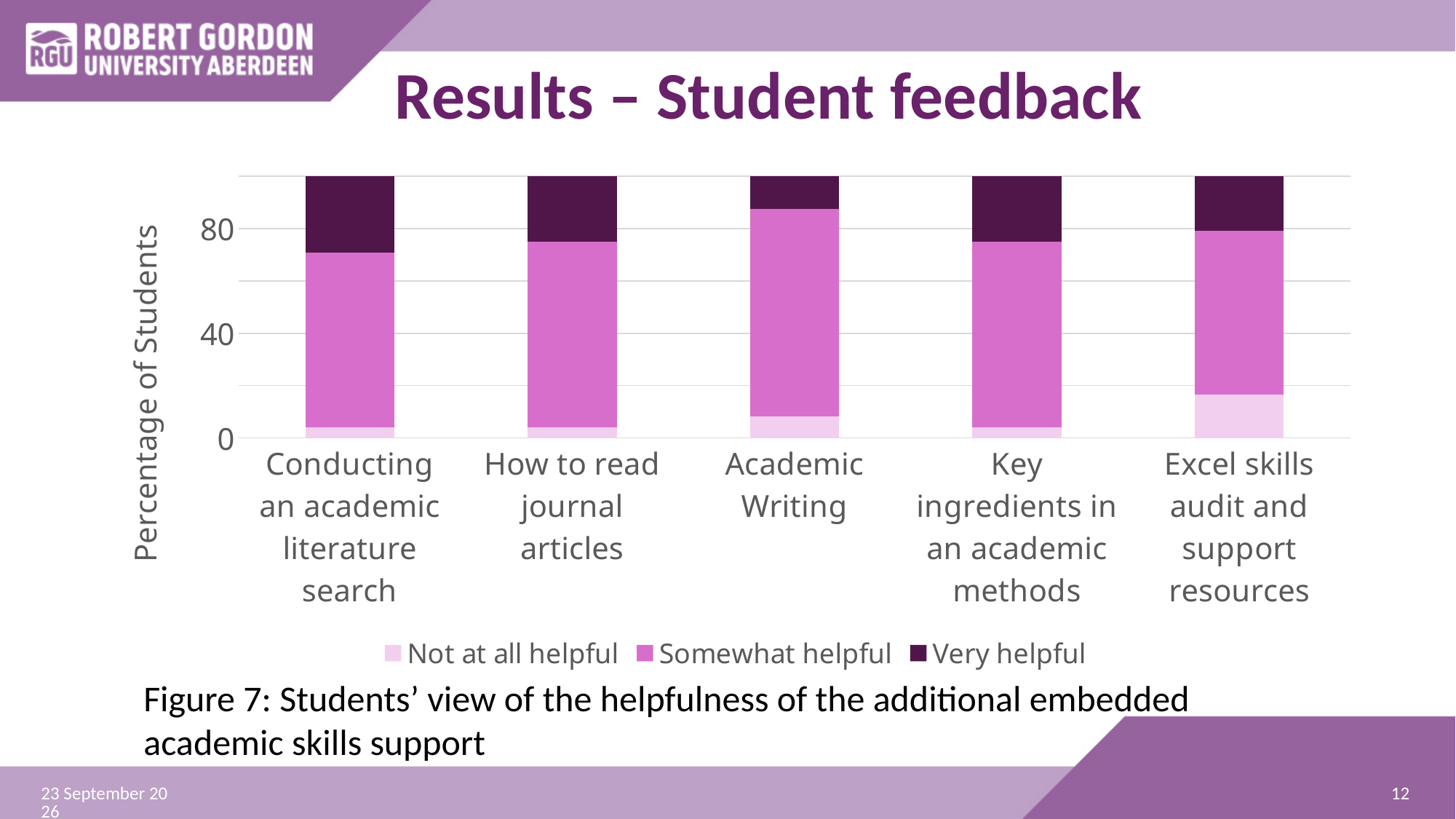
How many series does the chart's legend list? 3 Which category has the largest Not at all helpful segment? Excel skills audit and support resources In the Academic Writing bar, is the top of the Somewhat helpful segment greater or less than 80? greater Is the Not at all helpful segment larger for Excel skills audit and support resources or for Academic Writing? Excel skills audit and support resources What kind of chart is shown on the slide? Stacked bar chart In the Conducting an academic literature search bar, is the top of the Somewhat helpful segment greater or less than 80? less How many categories (workshops) are shown along the x axis of the chart? 5 Is the Very helpful segment larger for Conducting an academic literature search or for Academic Writing? Conducting an academic literature search What is the label on the vertical axis of the chart? Percentage of Students Is the Not at all helpful value for Excel skills audit and support resources greater or less than 40? less Which category has the smallest Very helpful segment? Academic Writing What are the three legend entries of the chart? Not at all helpful, Somewhat helpful, Very helpful